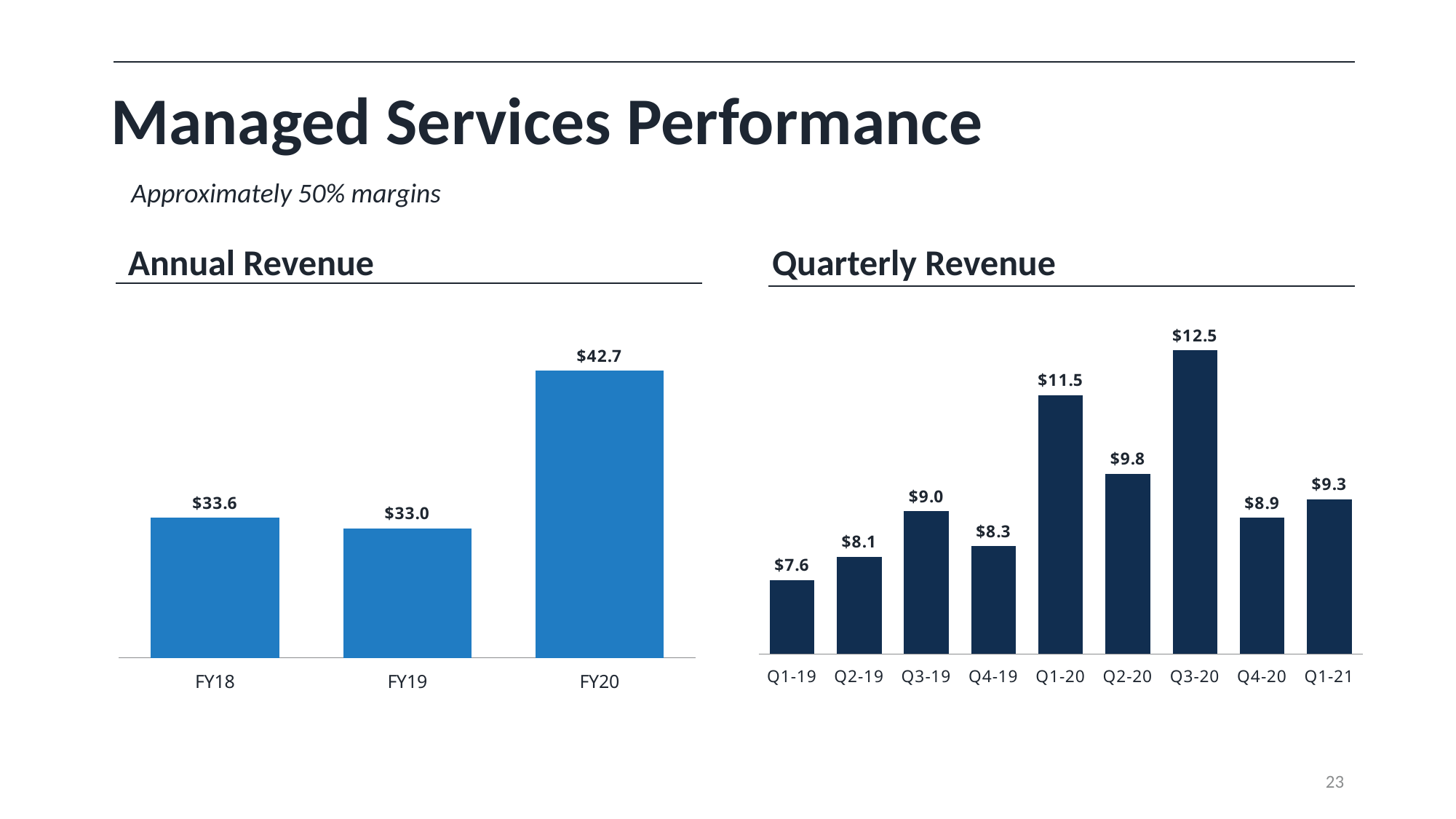
In the Quarterly Revenue chart, what is the difference between Q3-20 and Q4-20? $3.6 What kind of chart is the Annual Revenue chart? Bar chart In the Quarterly Revenue chart, how many quarters are shown? 9 In the Annual Revenue chart, what is the value for FY20? $42.7 In the Quarterly Revenue chart, which quarter has the lowest revenue? Q1-19 In the Quarterly Revenue chart, do values rise or fall from Q1-19 to Q3-20? Rise In the Annual Revenue chart, how many years are shown? 3 In the Quarterly Revenue chart, which is larger, Q1-20 or Q1-21? Q1-20 In the Annual Revenue chart, which year has the lowest revenue? FY19 In the Annual Revenue chart, what is the difference between FY20 and FY19? $9.7 In the Quarterly Revenue chart, which quarter has the highest revenue? Q3-20 In the Quarterly Revenue chart, what is the value for Q2-20? $9.8